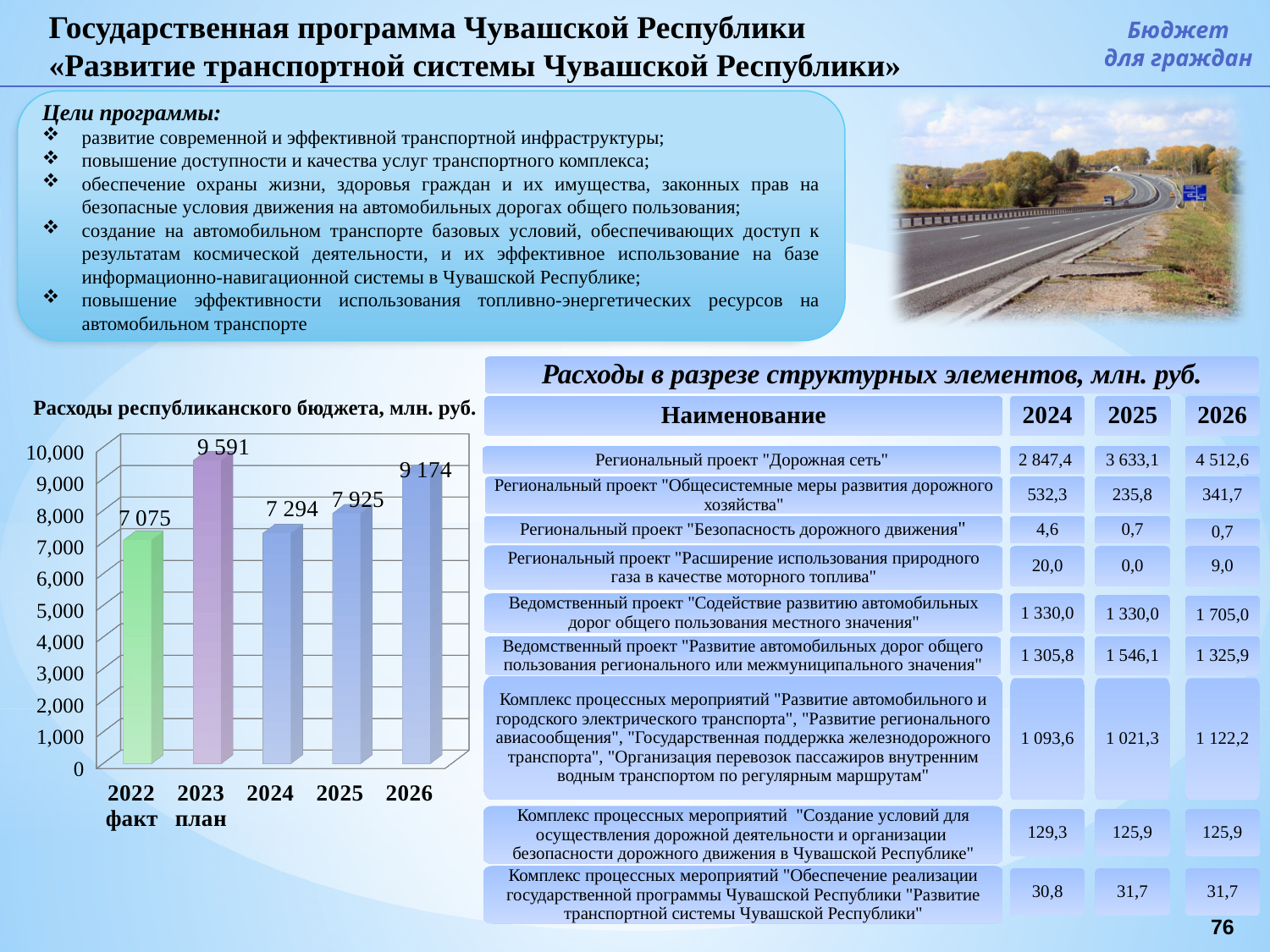
In the chart "Расходы республиканского бюджета, млн. руб.", is the value for 2026 greater or less than 9,000? greater Which year has the highest value in the chart "Расходы республиканского бюджета, млн. руб."? 2023 What is the value for 2023 in the chart "Расходы республиканского бюджета, млн. руб."? 9 591 Which year has the lowest value in the chart "Расходы республиканского бюджета, млн. руб."? 2022 What is the value for 2026 in the chart "Расходы республиканского бюджета, млн. руб."? 9 174 What kind of chart is "Расходы республиканского бюджета, млн. руб."? bar chart In the chart "Расходы республиканского бюджета, млн. руб.", do the values rise or fall from 2024 to 2026? rise In the chart "Расходы республиканского бюджета, млн. руб.", what is the difference between the values for 2026 and 2025? 1 249 In the chart "Расходы республиканского бюджета, млн. руб.", which is larger, the value for 2024 or the value for 2025? 2025 How many years are shown in the chart "Расходы республиканского бюджета, млн. руб."? 5 In the chart "Расходы республиканского бюджета, млн. руб.", what is the difference between the values for 2023 and 2022? 2 516 What is the value for 2022 in the chart "Расходы республиканского бюджета, млн. руб."? 7 075